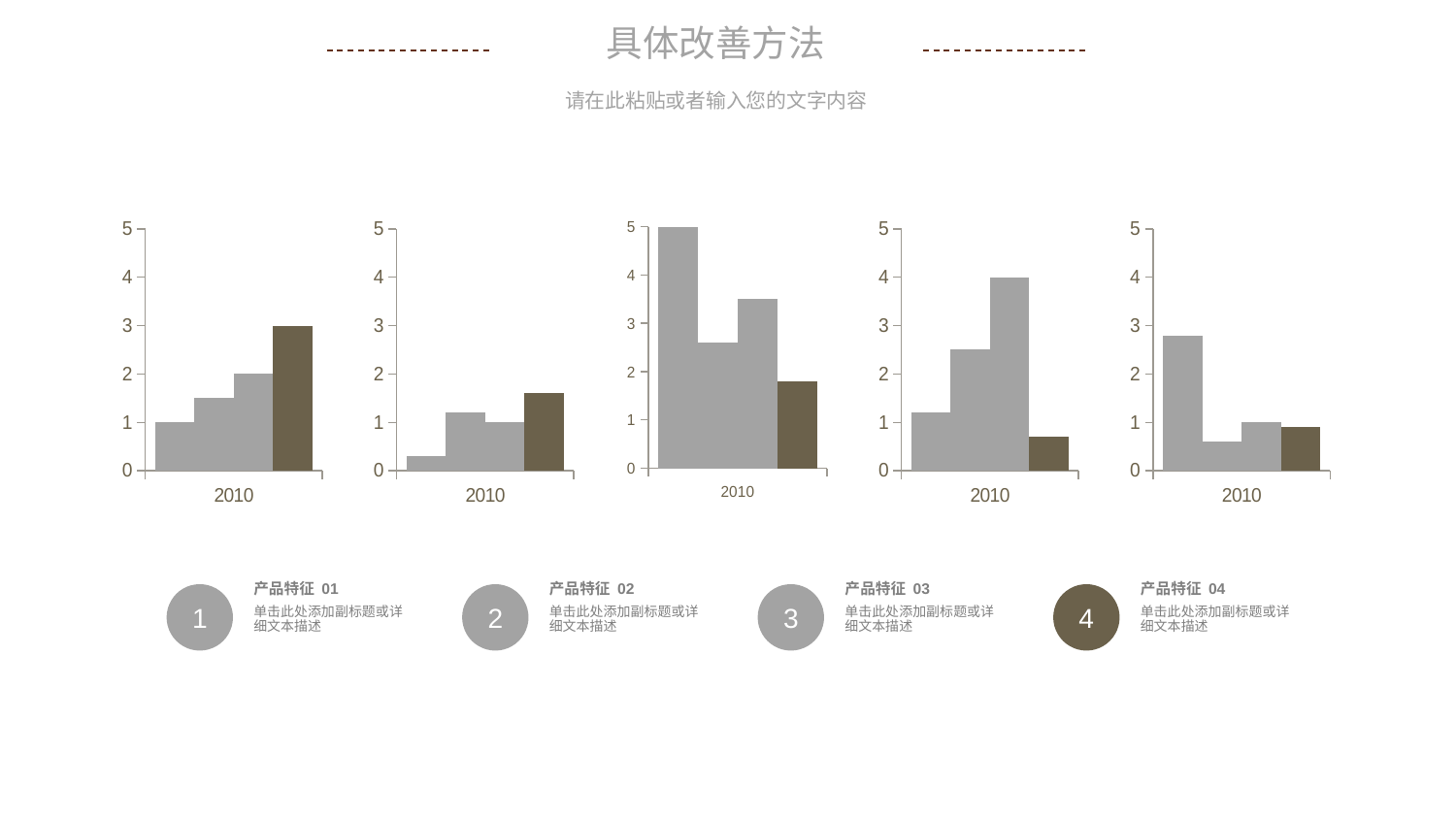
In the middle chart, which bar is the lowest: the first, second, third or fourth? fourth How many bar charts are shown on the slide? 5 In the leftmost chart, what is the value of the tallest (dark brown) bar? 3 In the fourth chart from the left, is the value of the dark brown bar greater or less than 1? less In the rightmost chart, is the value of the first bar greater or less than 2? greater In the middle chart, what is the value of the first (leftmost) bar? 5 In the second chart from the left, which bar is taller: the first bar or the dark brown bar? the dark brown bar In the leftmost chart, how many bars are plotted? 4 What is the x-axis category label shown under the middle chart? 2010 In the leftmost chart, do the bar values rise or fall from left to right? rise In the fourth chart from the left, what is the value of the third bar? 4 What kind of chart is the leftmost chart on the slide? bar chart